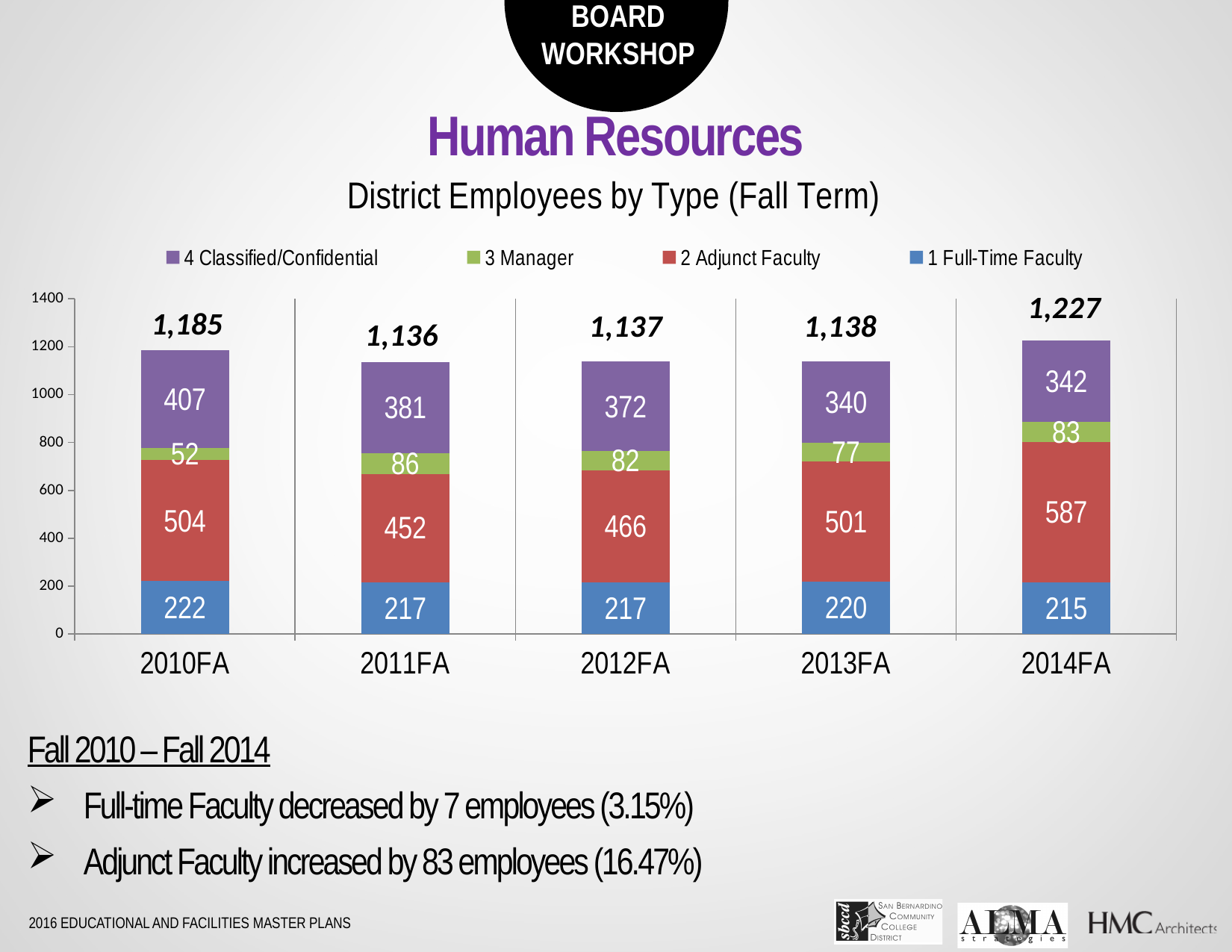
What is the value for 4 Classified/Confidential in 2010FA? 407 What is the total of the stacked bar for 2014FA? 1,227 What is the difference between the 2 Adjunct Faculty values in 2014FA and 2010FA? 83 Which is larger: the 3 Manager value in 2011FA or in 2012FA? 2011FA What is the title of the chart? District Employees by Type (Fall Term) How many fall terms are shown on the x axis? 5 Which fall term has the lowest total number of district employees? 2011FA What is the value for 3 Manager in 2013FA? 77 Which fall term has the highest total number of district employees? 2014FA How many series does the legend list? 4 What is the value for 2 Adjunct Faculty in 2014FA? 587 What kind of chart is shown on the slide? Stacked bar chart